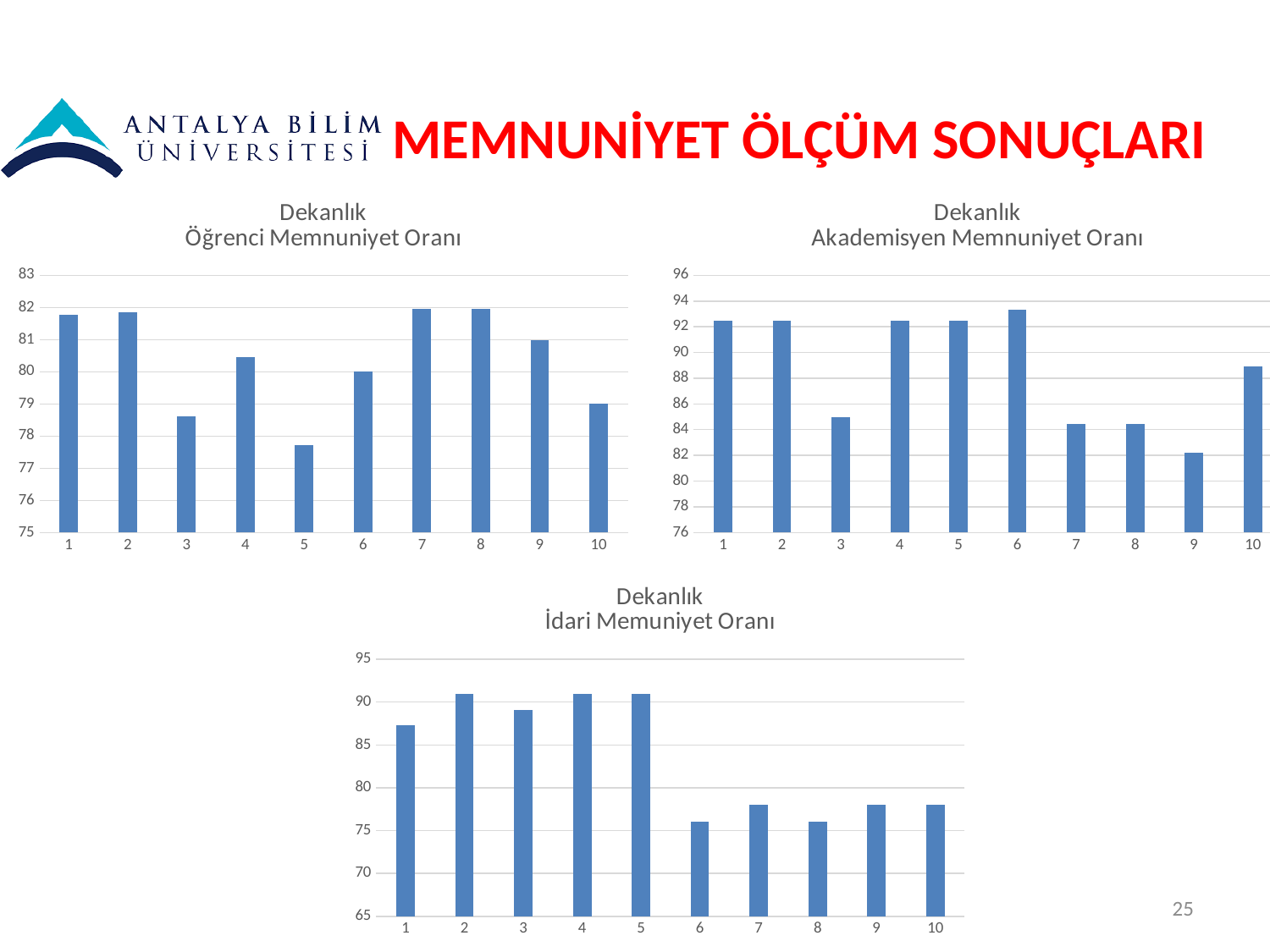
In the 'Dekanlık Öğrenci Memnuniyet Oranı' chart, is the value for category 3 greater or less than 79? less In the 'Dekanlık İdari Memuniyet Oranı' chart, is the value for category 6 greater or less than 80? less In the 'Dekanlık Akademisyen Memnuniyet Oranı' chart, which category has the lowest value? 9 In the 'Dekanlık Öğrenci Memnuniyet Oranı' chart, which is larger, the value for category 4 or the value for category 5? 4 In the 'Dekanlık Akademisyen Memnuniyet Oranı' chart, is the value for category 10 greater or less than 88? greater In the 'Dekanlık Öğrenci Memnuniyet Oranı' chart, which category has the lowest value? 5 In the 'Dekanlık Akademisyen Memnuniyet Oranı' chart, which is larger, the value for category 3 or the value for category 7? 3 How many categories are shown on the x axis of the 'Dekanlık Akademisyen Memnuniyet Oranı' chart? 10 What is the title of the chart at the bottom of the slide? Dekanlık İdari Memuniyet Oranı In the 'Dekanlık İdari Memuniyet Oranı' chart, which is larger, the value for category 2 or the value for category 8? 2 What kind of chart is the 'Dekanlık Öğrenci Memnuniyet Oranı' chart? bar chart In the 'Dekanlık Akademisyen Memnuniyet Oranı' chart, which category has the highest value? 6